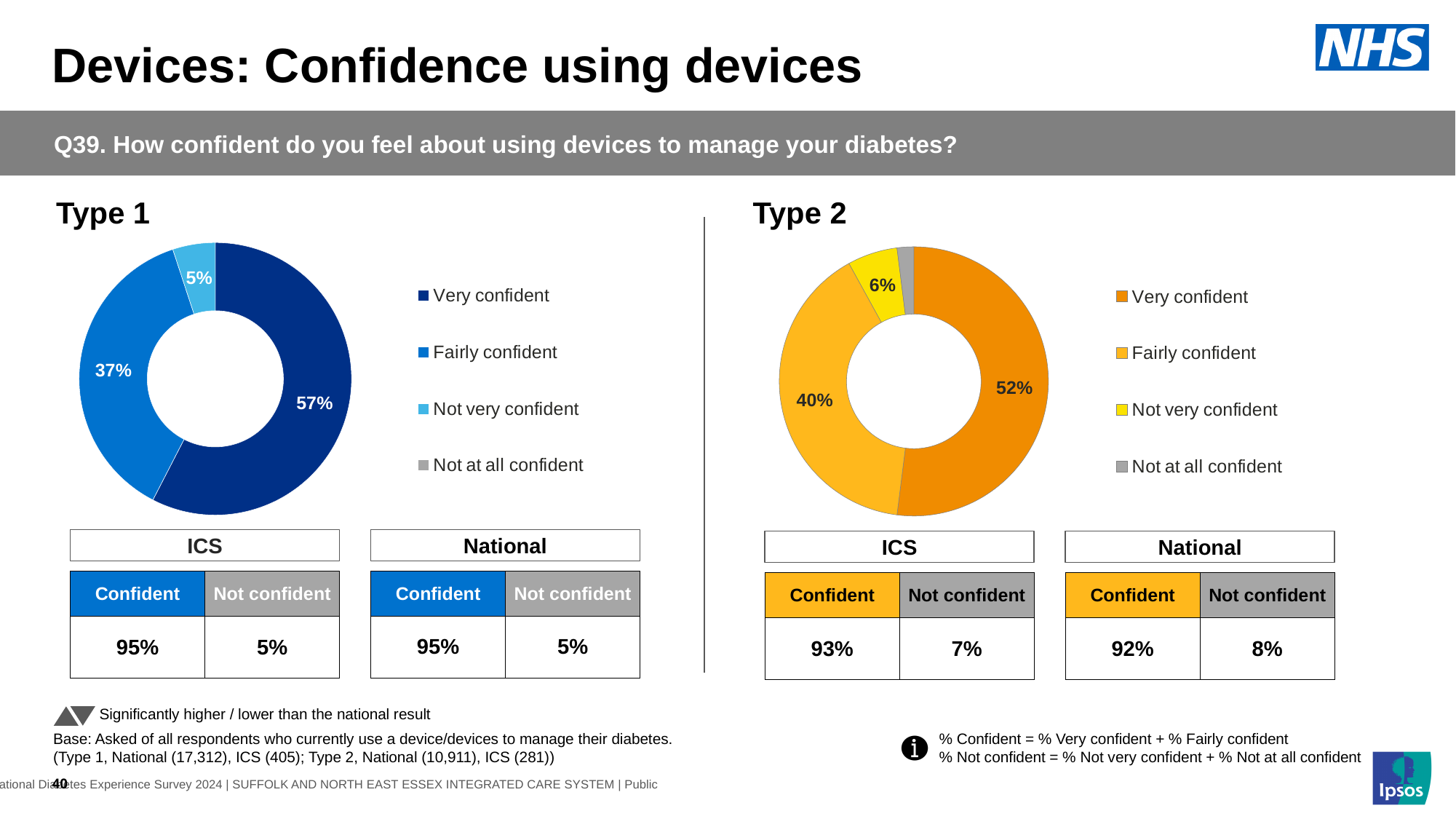
In the Type 2 chart, what is the difference between the very confident and fairly confident shares? 12 percentage points In the Type 1 chart, what percentage of respondents are very confident? 57% In the Type 1 chart, which category has the largest share? Very confident In the Type 2 chart, what percentage of respondents are not very confident? 6% Which chart has the larger very confident share, Type 1 or Type 2? Type 1 In the Type 1 chart, what percentage of respondents are fairly confident? 37% What kind of chart is used for the Type 1 and Type 2 results? Donut (pie) chart In the Type 1 chart, what percentage of respondents are not very confident? 5% In the Type 2 chart, what percentage of respondents are fairly confident? 40% In the Type 2 chart, which category has the largest share? Very confident In the Type 2 chart, what percentage of respondents are very confident? 52% In the Type 1 chart, what is the difference between the very confident and fairly confident shares? 20 percentage points